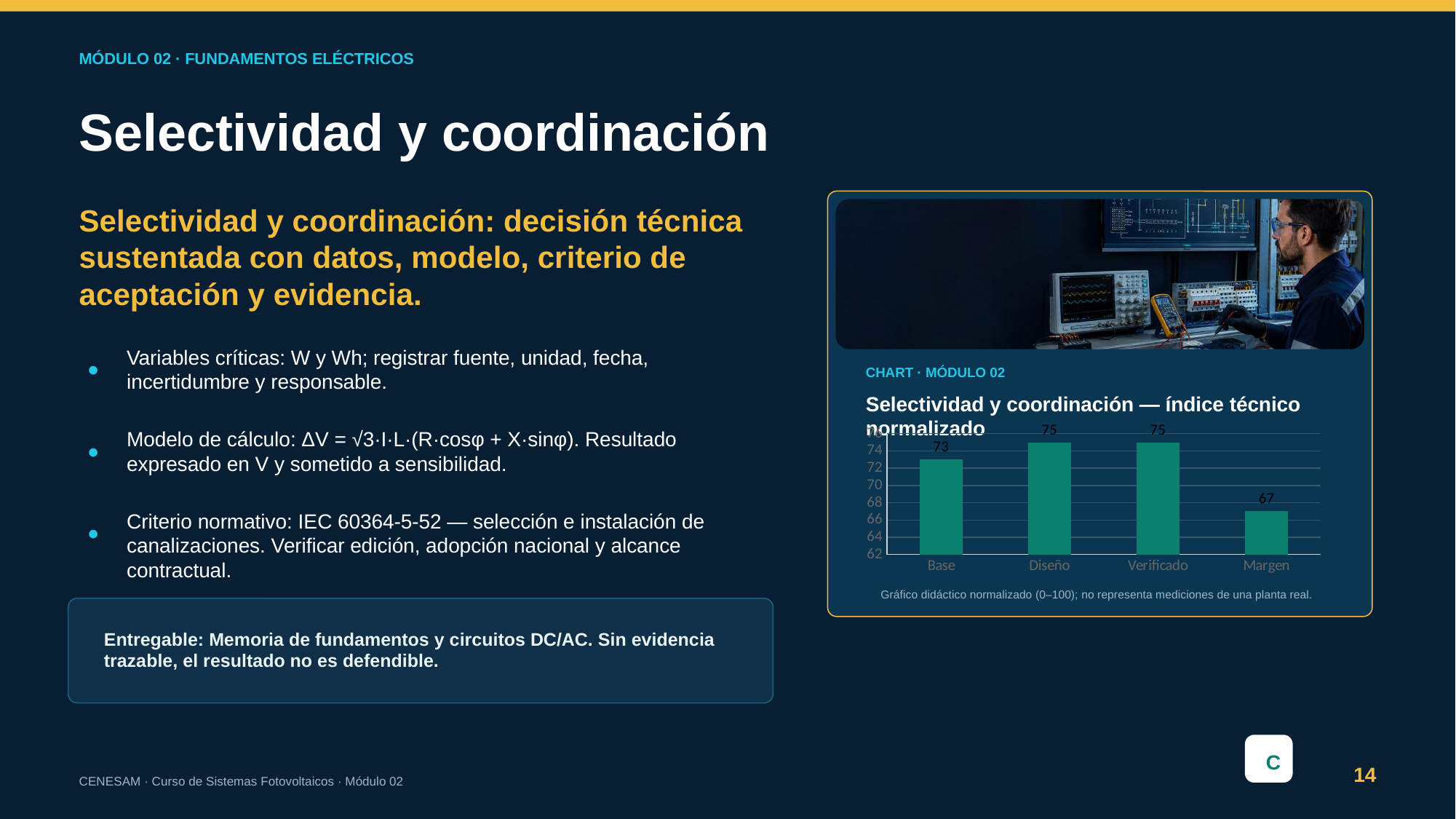
What is the difference between the values for Diseño and Margen? 8 What is the difference between the values for Base and Margen? 6 Which is larger, the value for Base or the value for Margen? Base Is the value for Margen greater or less than 70? less What is the value for Diseño? 75 What is the value for Base? 73 Which category has the lowest value? Margen What is the value for Margen? 67 What is the title of the chart? Selectividad y coordinación — índice técnico normalizado What is the value for Verificado? 75 What kind of chart is shown on the slide? bar chart How many categories are shown on the x axis? 4